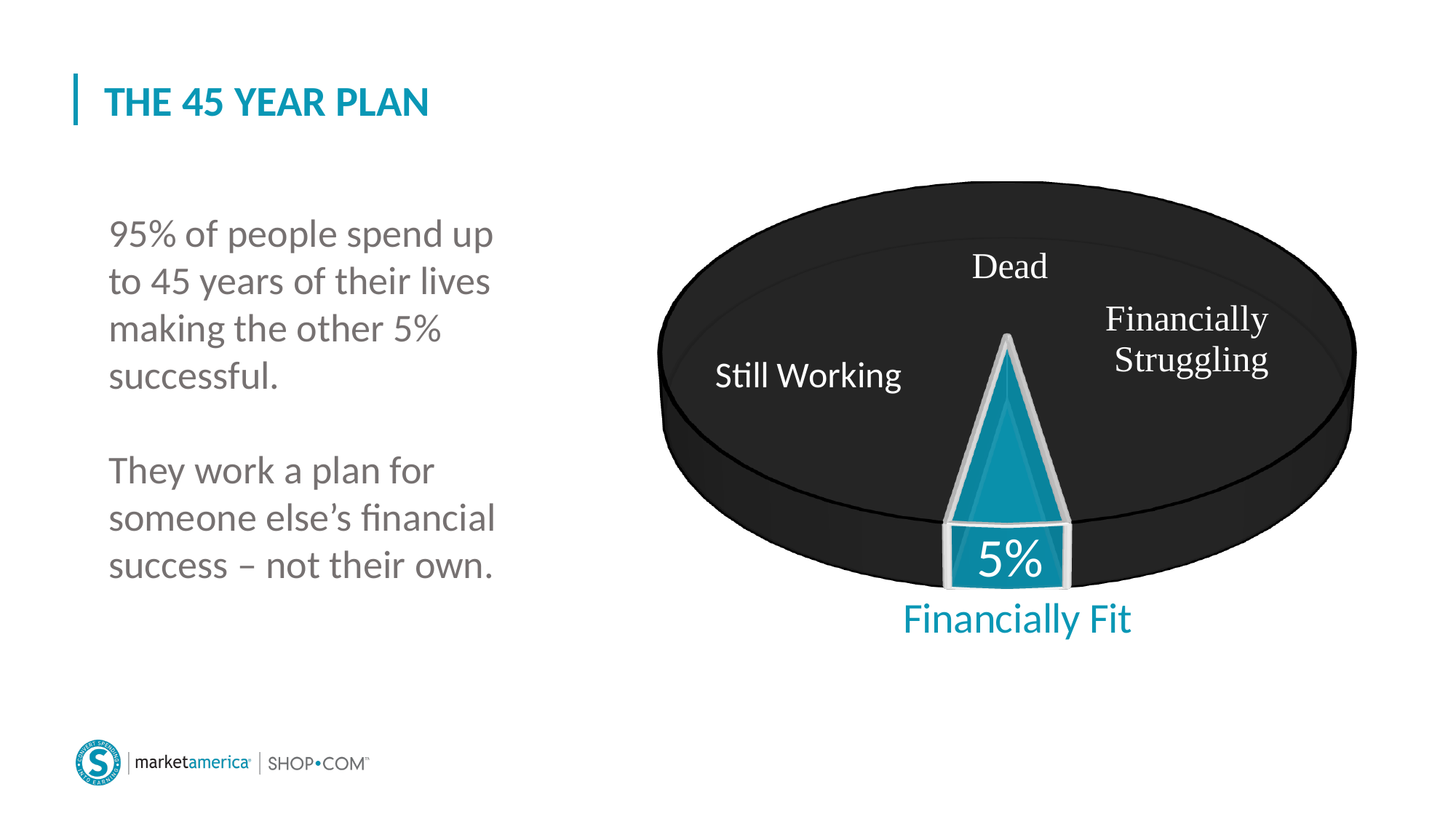
What share of the pie does the Financially Fit slice represent? 5% What colour is the Financially Fit slice of the pie chart? blue How many category labels appear on the pie chart? 4 Which category has the smallest slice in the pie chart? Financially Fit Is the Financially Fit slice larger or smaller than the rest of the pie combined? smaller What kind of chart is shown on the slide? pie chart Which category is labelled on the highlighted (blue) slice of the pie chart? Financially Fit What is the title of the slide containing the pie chart? THE 45 YEAR PLAN What value is printed on the highlighted slice of the pie chart? 5%